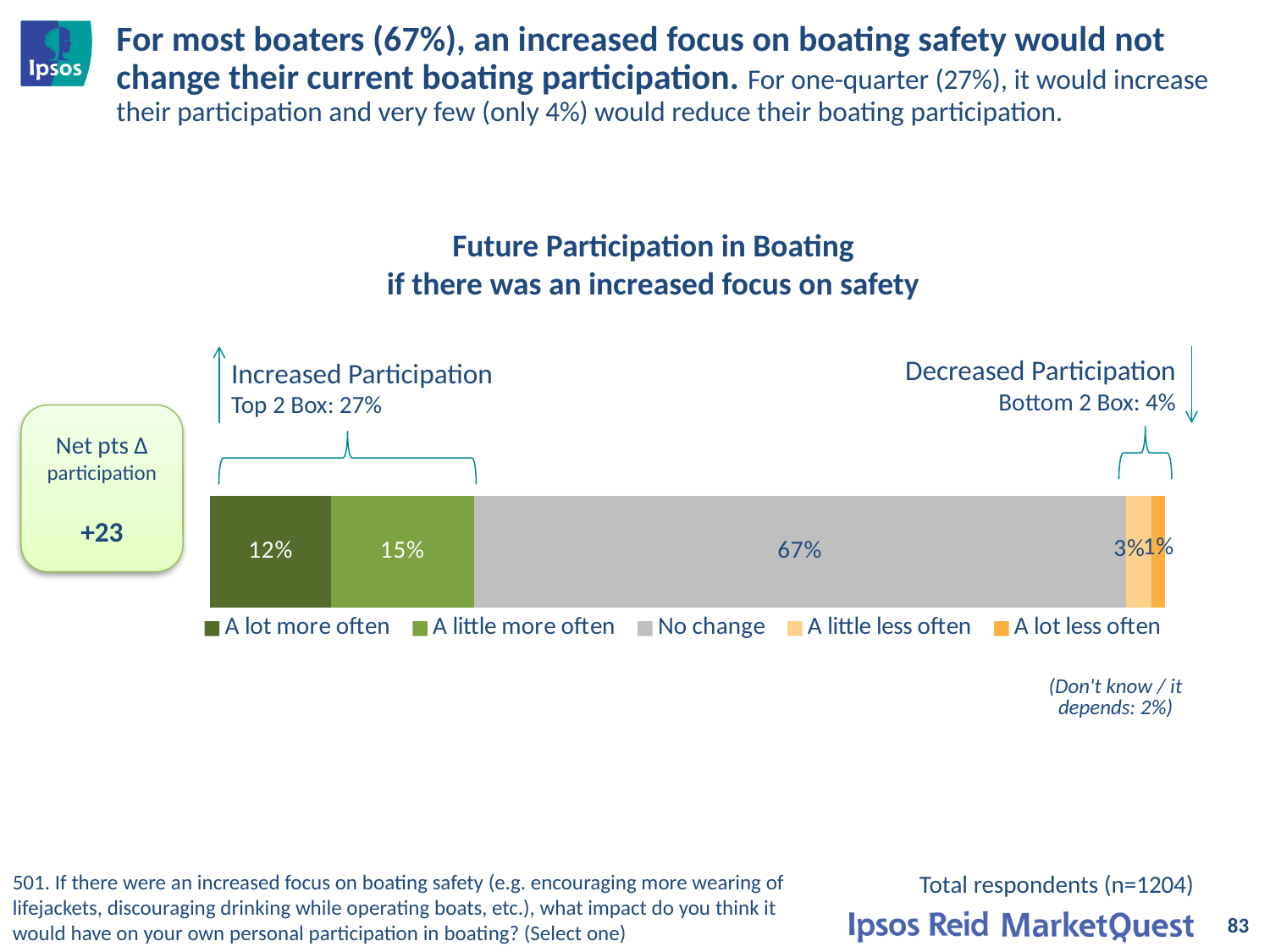
What percentage of respondents said they would boat "A little less often"? 3% How many response categories does the legend list? 5 What percentage of respondents said they would boat "A lot more often"? 12% What is the title of the chart? Future Participation in Boating if there was an increased focus on safety Which response category has the smallest share of the bar? A lot less often What type of chart is shown on the slide? Stacked bar chart What percentage of respondents said they would boat "A lot less often"? 1% What percentage of respondents said "No change"? 67% What is the difference in percentage points between "A little more often" and "A lot more often"? 3 Which response category has the largest share of the bar? No change What is the combined percentage of "A lot more often" and "A little more often"? 27% Which is larger, the share for "A little more often" or the share for "A little less often"? A little more often